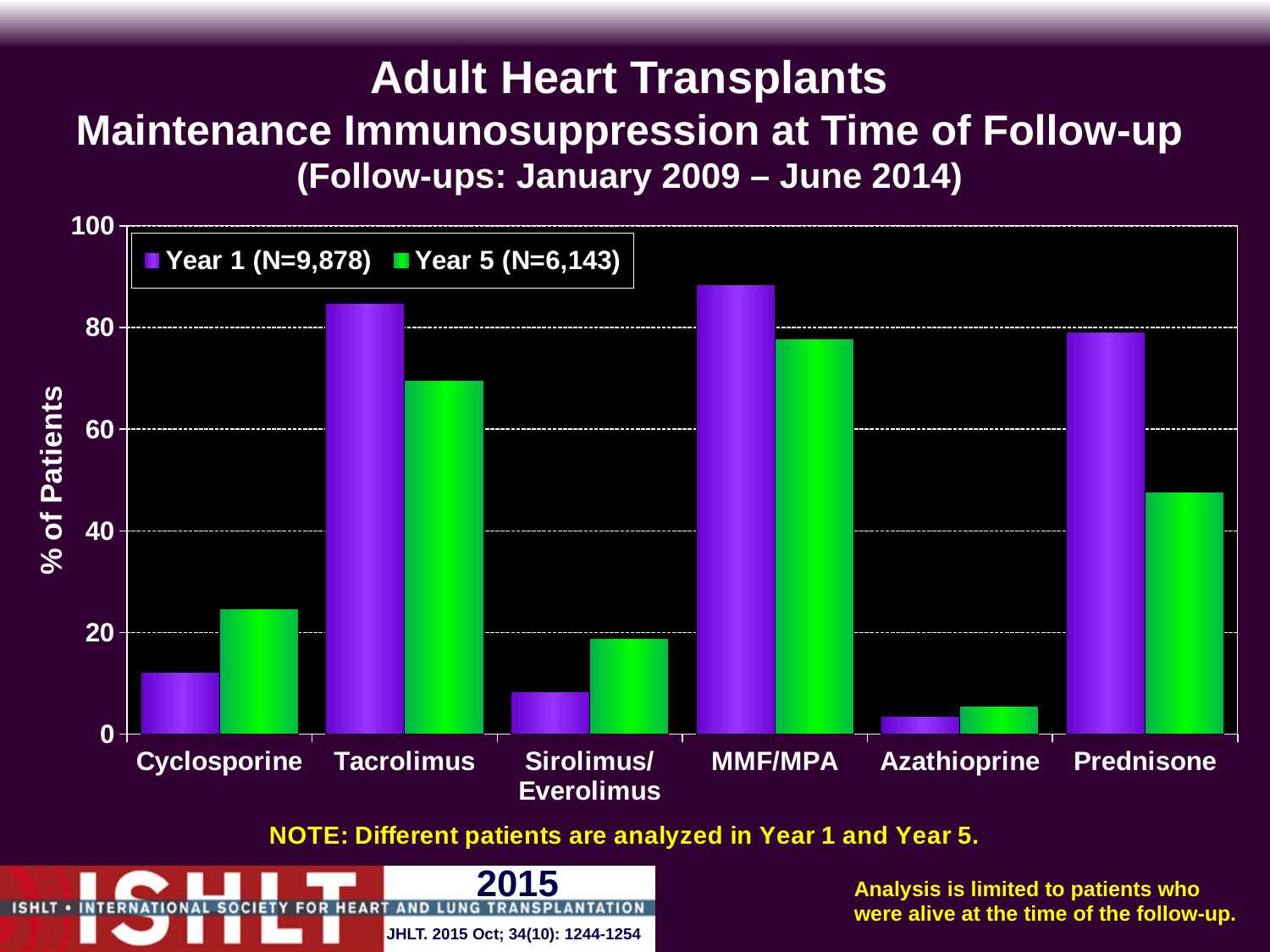
How many drug categories are shown on the x axis? 6 Is the Year 5 value for Cyclosporine greater or less than 20? greater For Cyclosporine, which is larger: the Year 1 value or the Year 5 value? Year 5 Is the Year 5 value for Prednisone greater or less than 60? less What kind of chart is shown on the slide? bar chart Which category has the lowest Year 5 value? Azathioprine For Prednisone, which is larger: the Year 1 value or the Year 5 value? Year 1 How many series does the legend list? 2 Which category has the lowest Year 1 value? Azathioprine Is the Year 1 value for Tacrolimus greater or less than 80? greater What is the label of the y axis? % of Patients Which category has the highest Year 5 value? MMF/MPA